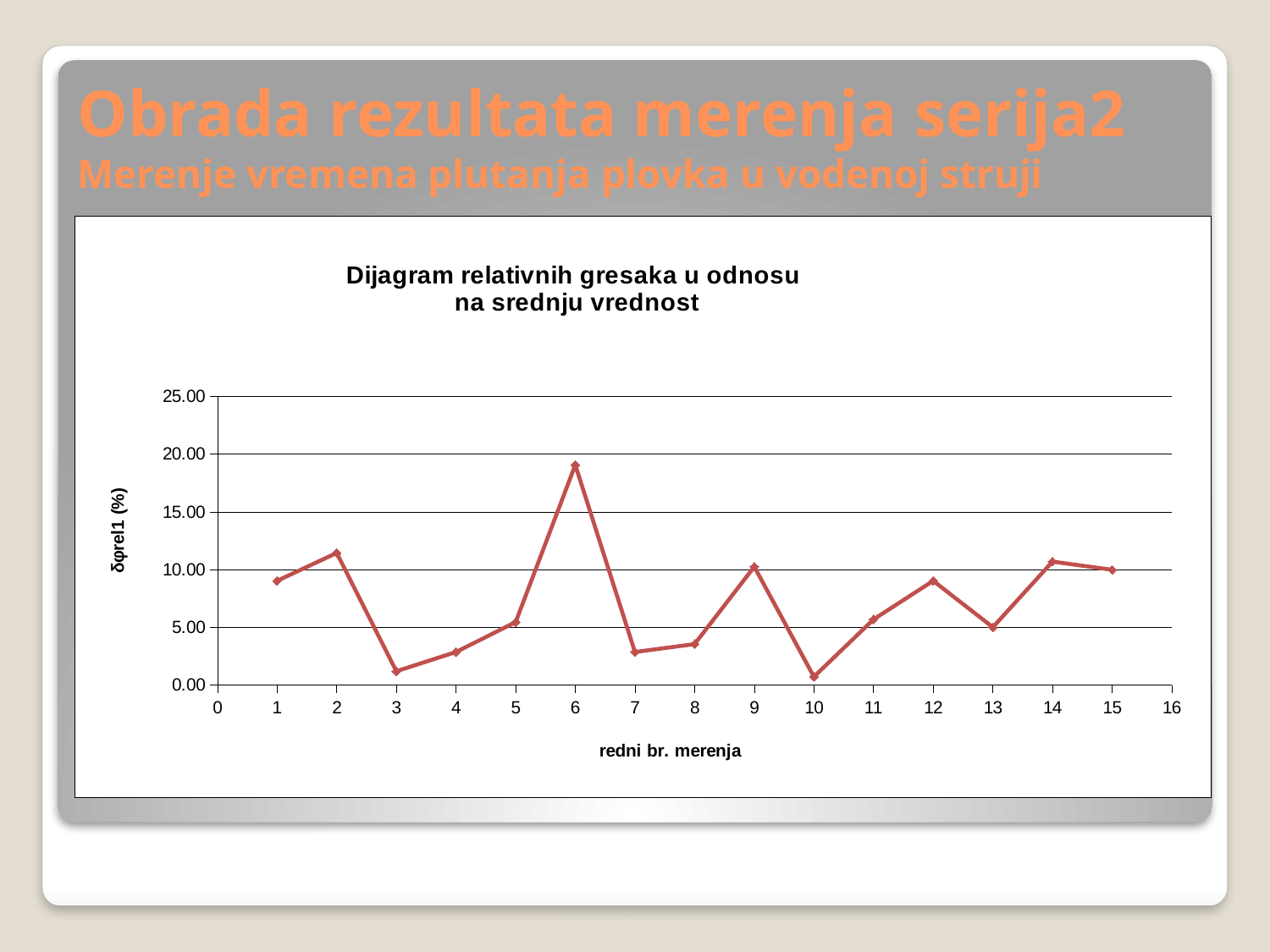
Does the relative error rise or fall from measurement 9 to measurement 10? fall What is the label of the x axis? redni br. merenja Is the value for measurement 13 greater or less than 10.00? less How many measurement points are plotted on the chart? 15 Which measurement number (redni br. merenja) has the lowest relative error? 10 What is the title of the chart? Dijagram relativnih gresaka u odnosu na srednju vrednost Which has the larger relative error, measurement 6 or measurement 2? measurement 6 Which measurement number (redni br. merenja) has the highest relative error? 6 Is the value for measurement 2 greater or less than 10.00? greater What kind of chart is shown on the slide? line chart Is the value for measurement 6 greater or less than 15.00? greater